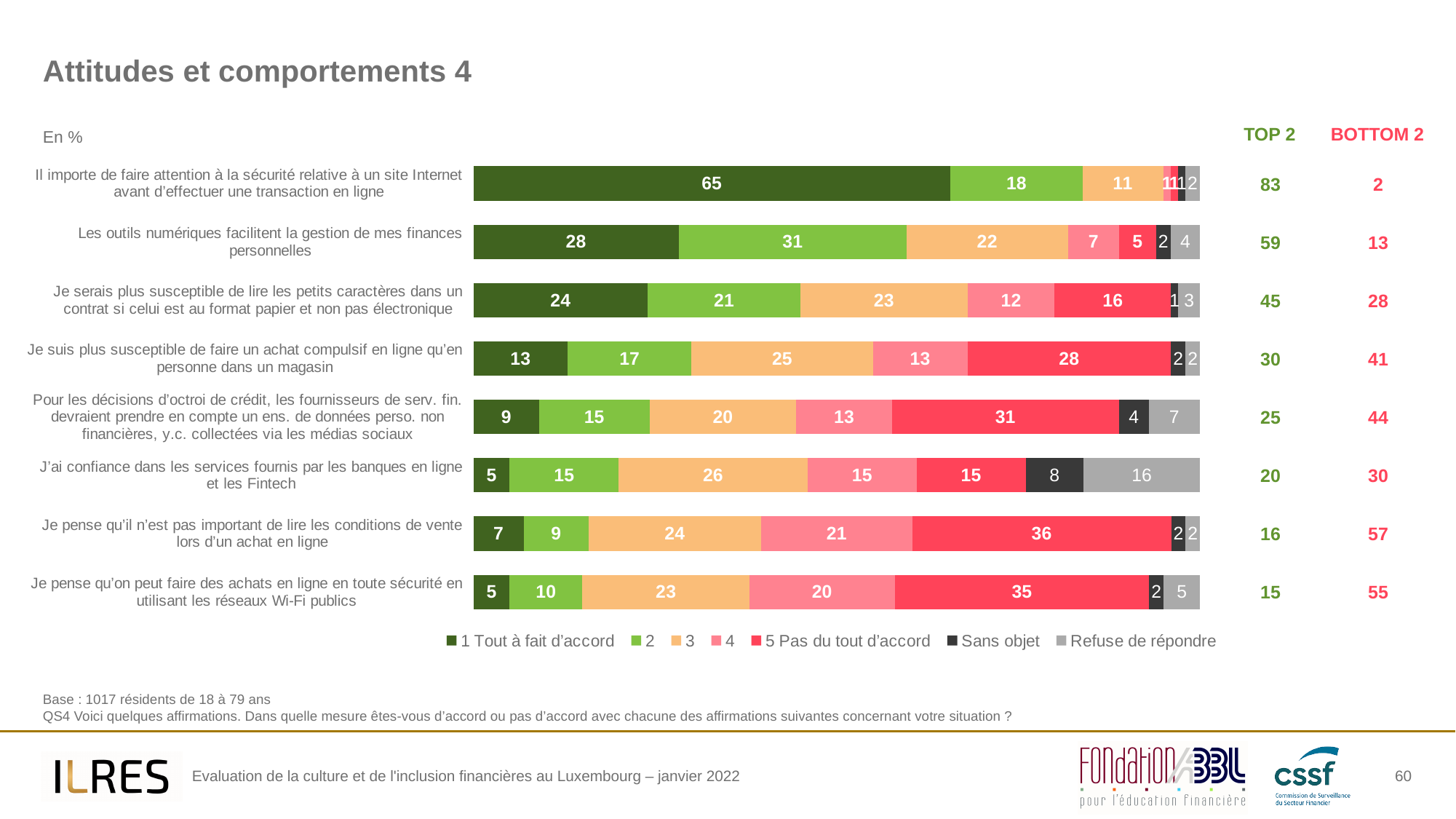
What is the BOTTOM 2 value shown for 'Pour les décisions d'octroi de crédit, les fournisseurs de serv. fin. devraient prendre en compte un ens. de données perso. non financières, y.c. collectées via les médias sociaux'? 44 Which statement has the highest value for '5 Pas du tout d'accord'? Je pense qu'il n'est pas important de lire les conditions de vente lors d'un achat en ligne What is the value of '1 Tout à fait d'accord' for 'Il importe de faire attention à la sécurité relative à un site Internet avant d'effectuer une transaction en ligne'? 65 Which statement has the highest value for '1 Tout à fait d'accord'? Il importe de faire attention à la sécurité relative à un site Internet avant d'effectuer une transaction en ligne What kind of chart is shown on the slide? Stacked bar chart What is the value of '5 Pas du tout d'accord' for 'Je pense qu'il n'est pas important de lire les conditions de vente lors d'un achat en ligne'? 36 What is the value of 'Refuse de répondre' for 'J'ai confiance dans les services fournis par les banques en ligne et les Fintech'? 16 How many series does the legend list? 7 How many statements (categories) are plotted in the chart? 8 What is the difference between the '2' value and the '1 Tout à fait d'accord' value for 'Les outils numériques facilitent la gestion de mes finances personnelles'? 3 Which is larger for 'Je suis plus susceptible de faire un achat compulsif en ligne qu'en personne dans un magasin': the value for '3' or the value for '5 Pas du tout d'accord'? 5 Pas du tout d'accord What is the TOP 2 value shown for 'Je serais plus susceptible de lire les petits caractères dans un contrat si celui est au format papier et non pas électronique'? 45